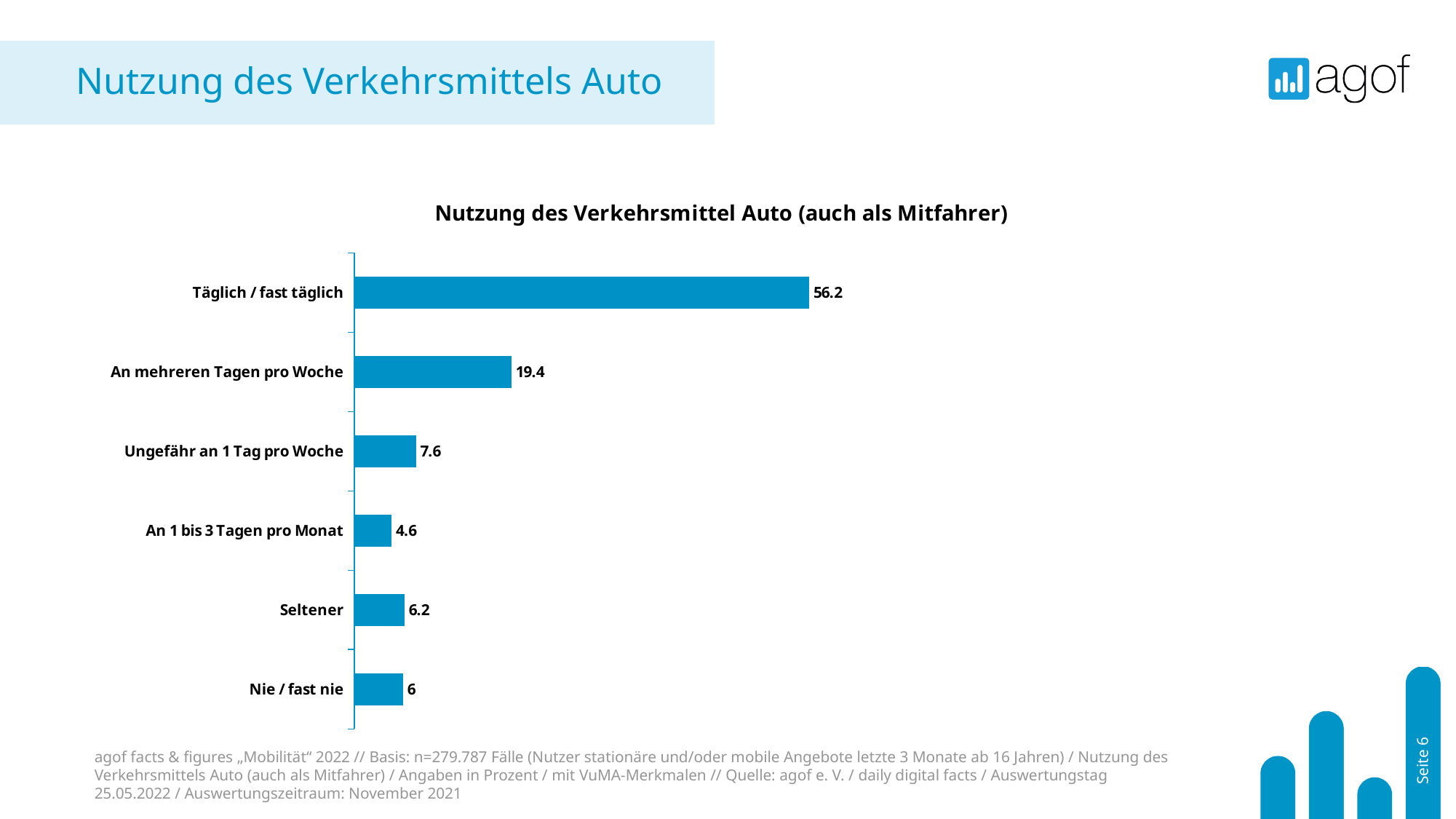
What is the difference between the values for "Täglich / fast täglich" and "An mehreren Tagen pro Woche"? 36.8 What kind of chart is shown on the slide? Bar chart What is the value for "Nie / fast nie"? 6 What is the value for "An mehreren Tagen pro Woche"? 19.4 Which category has the lowest value? An 1 bis 3 Tagen pro Monat What is the value for "Täglich / fast täglich"? 56.2 Which is larger, the value for "Ungefähr an 1 Tag pro Woche" or the value for "Seltener"? Ungefähr an 1 Tag pro Woche What is the difference between the values for "Seltener" and "An 1 bis 3 Tagen pro Monat"? 1.6 Which category has the highest value? Täglich / fast täglich How many categories are shown in the chart? 6 What is the title of the chart? Nutzung des Verkehrsmittel Auto (auch als Mitfahrer) What is the value for "Ungefähr an 1 Tag pro Woche"? 7.6